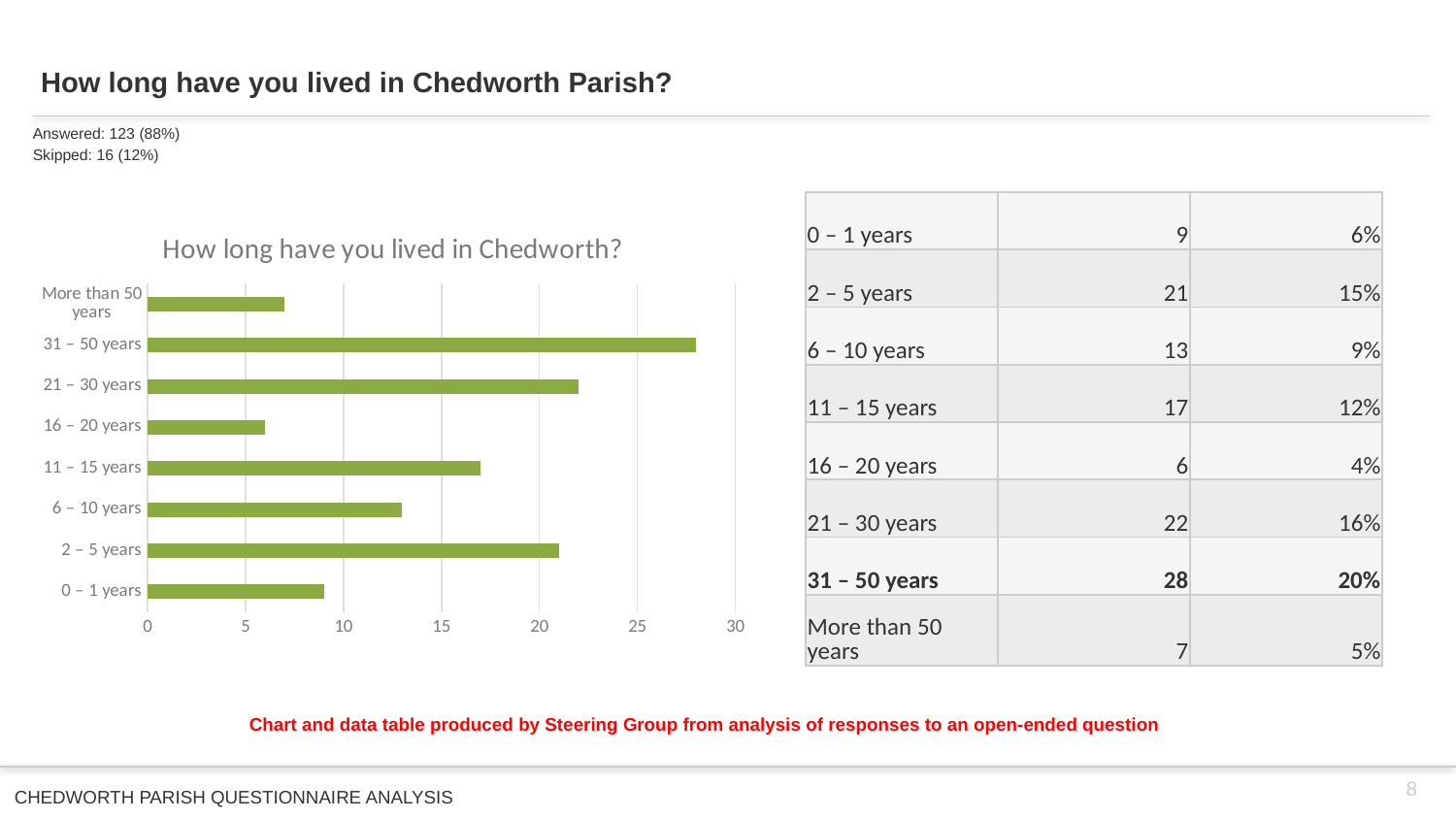
What is the value for 0 – 1 years? 9 Which category has the lowest value in the chart? 16 – 20 years What is the difference between the values for 31 – 50 years and 2 – 5 years? 7 What type of chart is shown on the slide? bar chart What is the title of the chart? How long have you lived in Chedworth? Is the value for 31 – 50 years greater or less than 25? greater What is the value for 21 – 30 years? 22 How many categories does the chart show? 8 Which is larger, the value for 11 – 15 years or the value for 6 – 10 years? 11 – 15 years Is the value for 16 – 20 years greater or less than 10? less What is the value for More than 50 years? 7 Which category has the highest value in the chart? 31 – 50 years